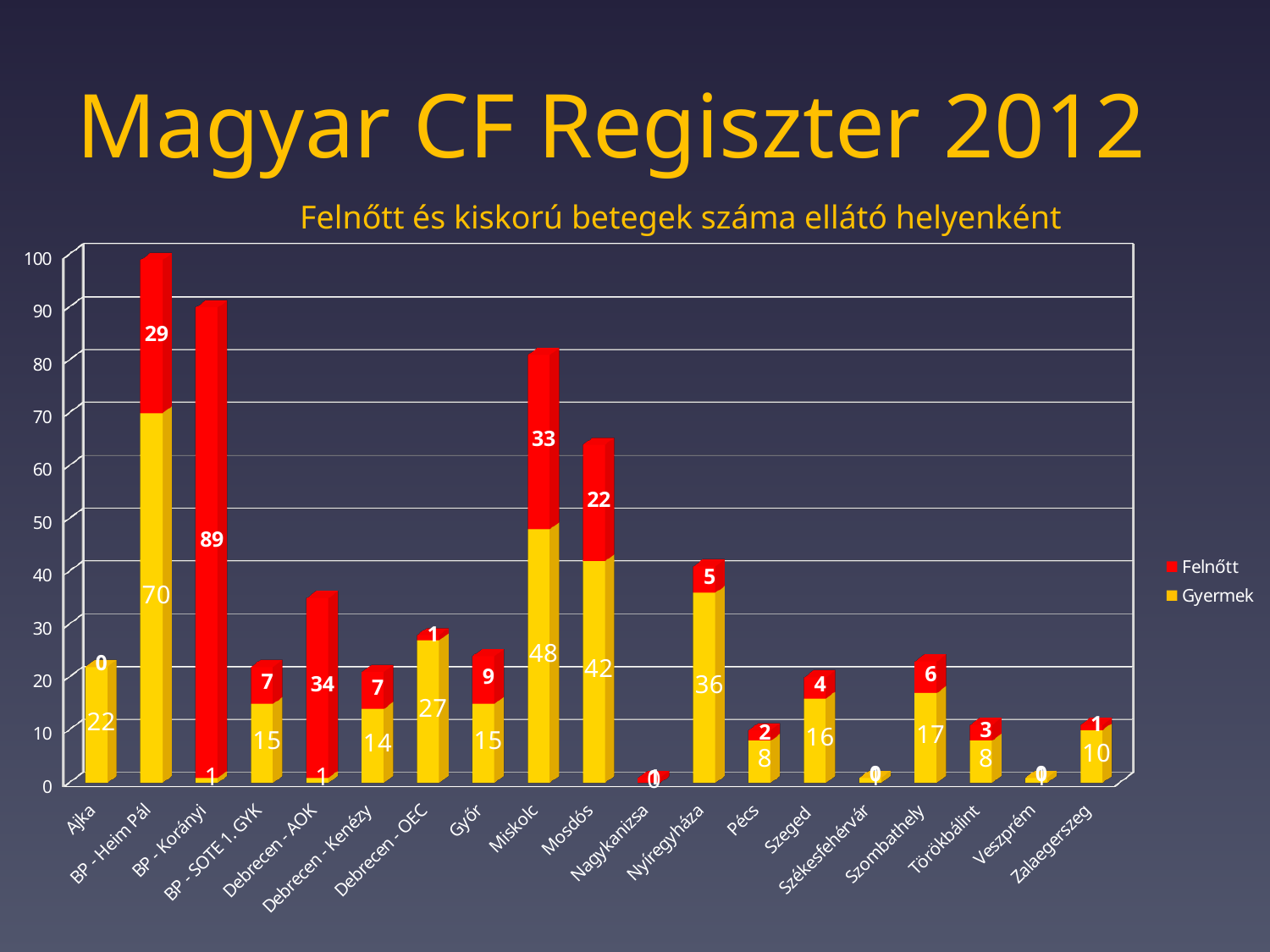
What is the subtitle of the chart? Felnőtt és kiskorú betegek száma ellátó helyenként Which category has the highest Gyermek value? BP - Heim Pál What is the difference between the Gyermek values for Miskolc and Mosdós? 6 How many series does the legend list? 2 Which category has the highest Felnőtt value? BP - Korányi What is the Felnőtt value for Miskolc? 33 What is the total of the stacked bar for Miskolc? 81 What is the Gyermek value for BP - Heim Pál? 70 What type of chart is shown on the slide? stacked bar chart What is the Felnőtt value for BP - Korányi? 89 What is the Gyermek value for Nyíregyháza? 36 Which is larger, the Felnőtt value for Debrecen - AOK or the Felnőtt value for Mosdós? Debrecen - AOK